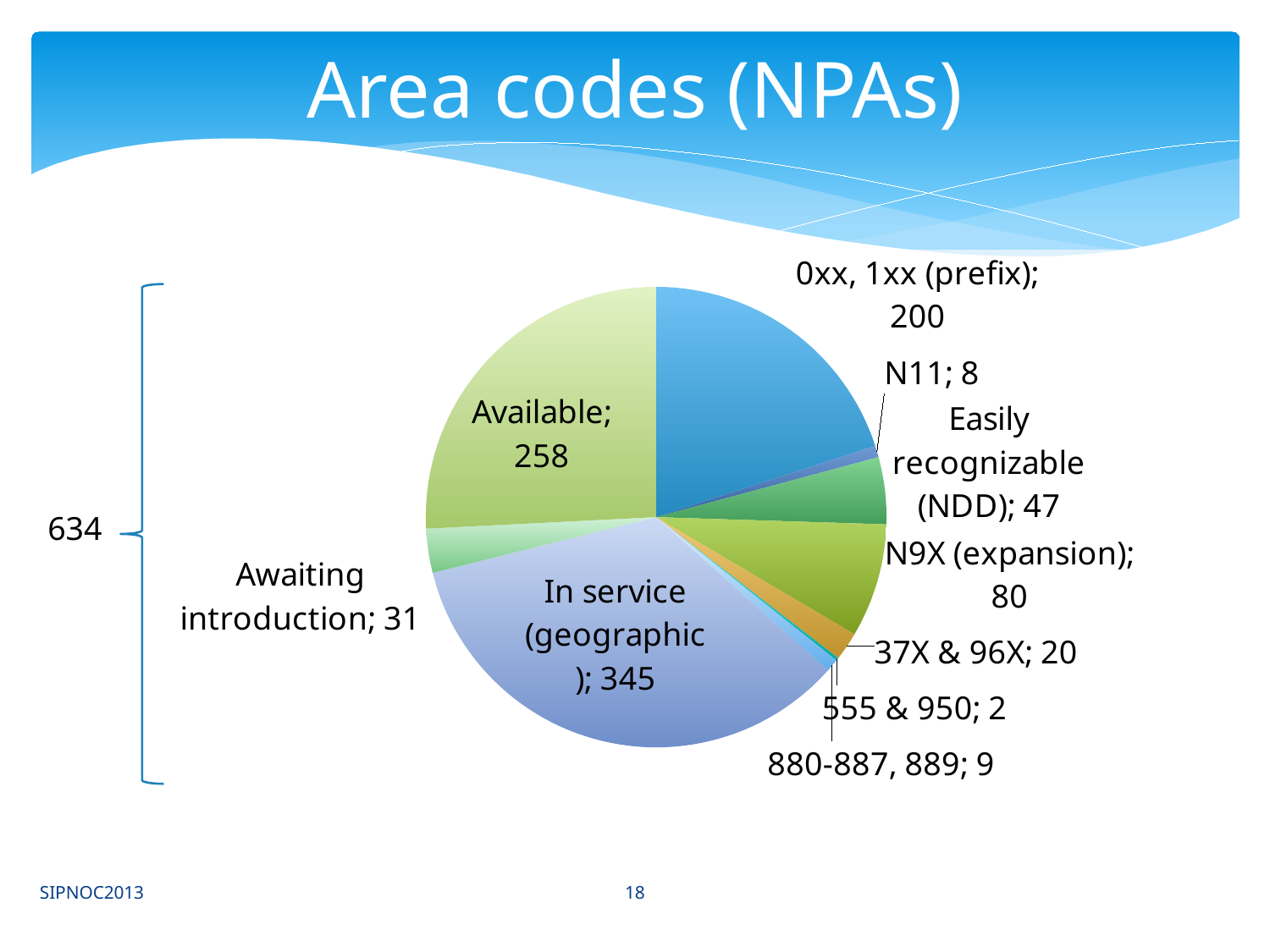
Which category has the smallest slice of the pie? 555 & 950 How many slices does the pie chart have? 10 What kind of chart is shown on the slide? pie chart What is the value for 'N9X (expansion)'? 80 What number is shown next to the bracket on the left of the chart? 634 What is the value for 'Easily recognizable (NDD)'? 47 What is the value for 'In service (geographic)'? 345 What is the value for 'Available'? 258 Which is larger, the value for 'Available' or the value for '0xx, 1xx (prefix)'? Available Which category has the largest slice of the pie? In service (geographic) What is the title of the chart on the slide? Area codes (NPAs) What is the difference between the values for 'In service (geographic)' and 'Available'? 87